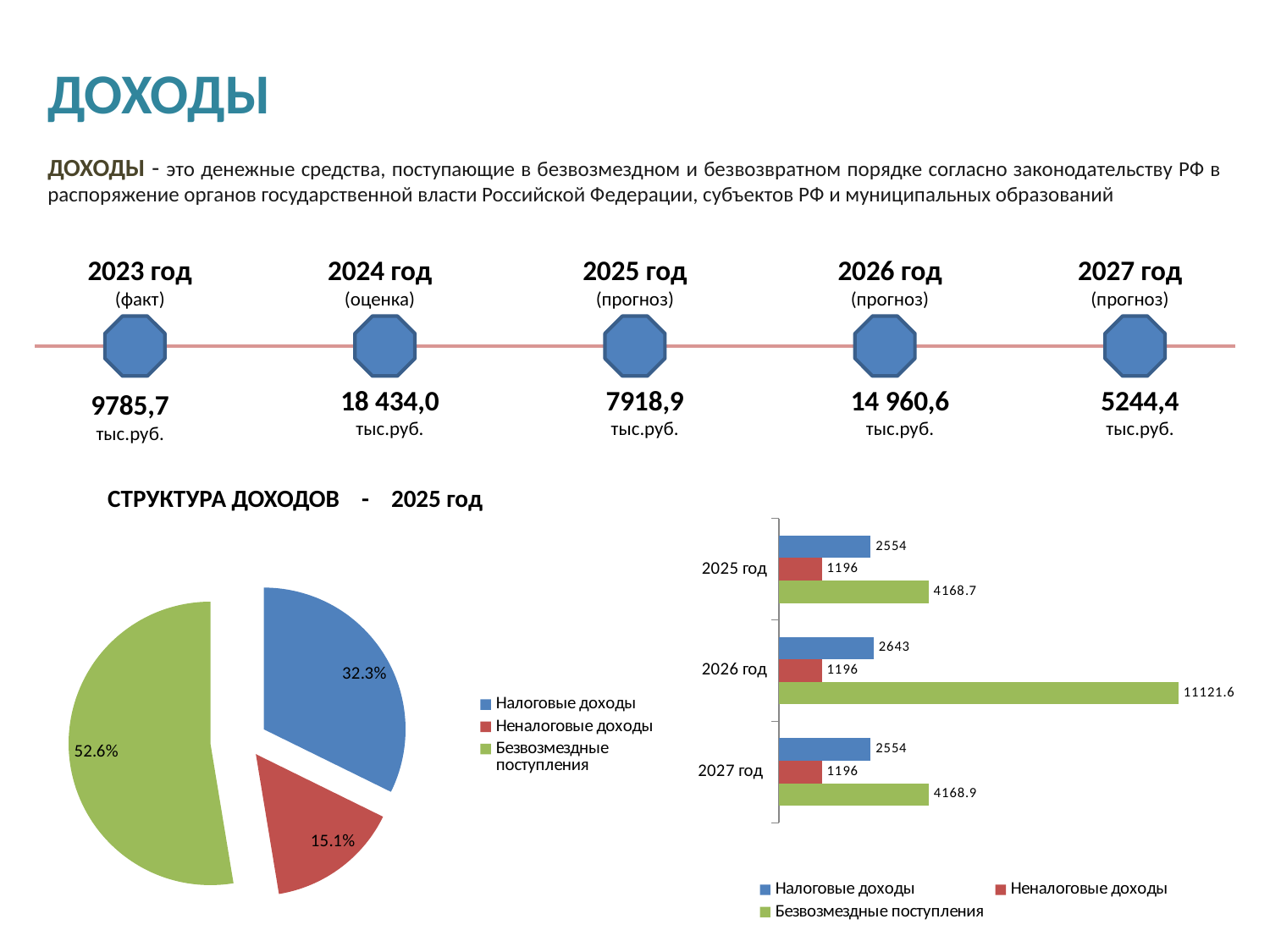
In the bar chart on the right, what is the value of Неналоговые доходы for 2027 год? 1196 In the pie chart on the left, what share is labelled for Неналоговые доходы? 15.1% In the bar chart on the right, which year has the highest value for Безвозмездные поступления? 2026 год In the bar chart on the right, how many series does the legend list? 3 In the bar chart on the right, what is the value of Безвозмездные поступления for 2026 год? 11121.6 In the pie chart on the left, what share is labelled for Безвозмездные поступления? 52.6% In the bar chart on the right, what is the difference between Налоговые доходы for 2026 год and for 2025 год? 89 In the pie chart on the left, which category has the largest slice? Безвозмездные поступления In the pie chart on the left, how many slices are there? 3 In the bar chart on the right, what is the value of Налоговые доходы for 2026 год? 2643 In the pie chart on the left, which category has the smallest slice? Неналоговые доходы What type of chart is shown on the right side of the slide? Bar chart